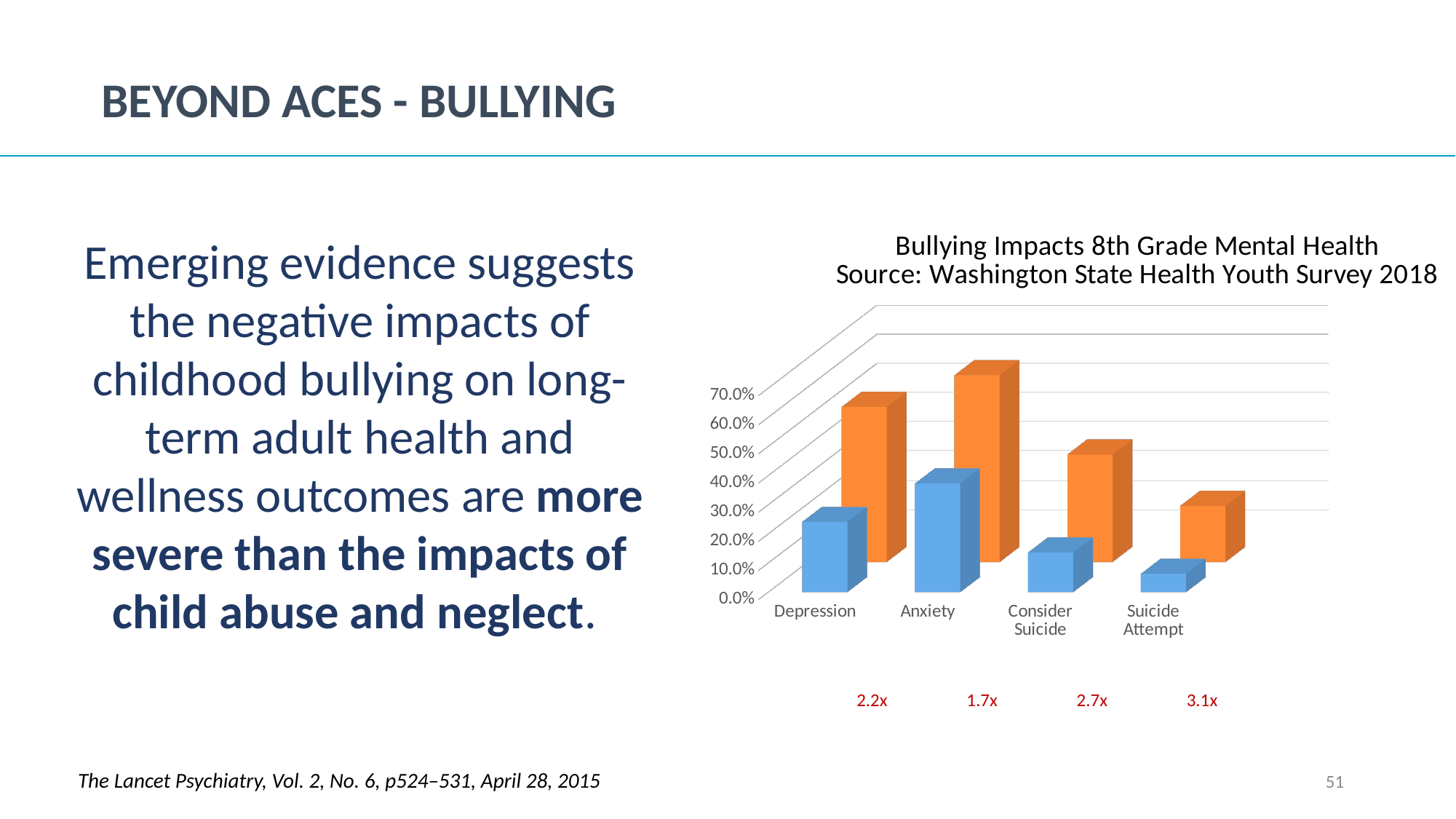
Which category has the shortest orange bar? Suicide Attempt Is the orange bar for Anxiety greater or less than 50.0%? greater For Consider Suicide, which bar is taller, the blue bar or the orange bar? orange Is the orange bar for Depression greater or less than 40.0%? greater What type of chart is shown on the slide? bar chart Is the blue bar for Suicide Attempt greater or less than 20.0%? less Which category has the shortest blue bar? Suicide Attempt What is the title of the chart? Bullying Impacts 8th Grade Mental Health What multiplier is printed in red below the Suicide Attempt category? 3.1x Which category has the tallest orange bar? Anxiety How many categories are shown on the x axis of the chart? 4 Which category has the tallest blue bar? Anxiety